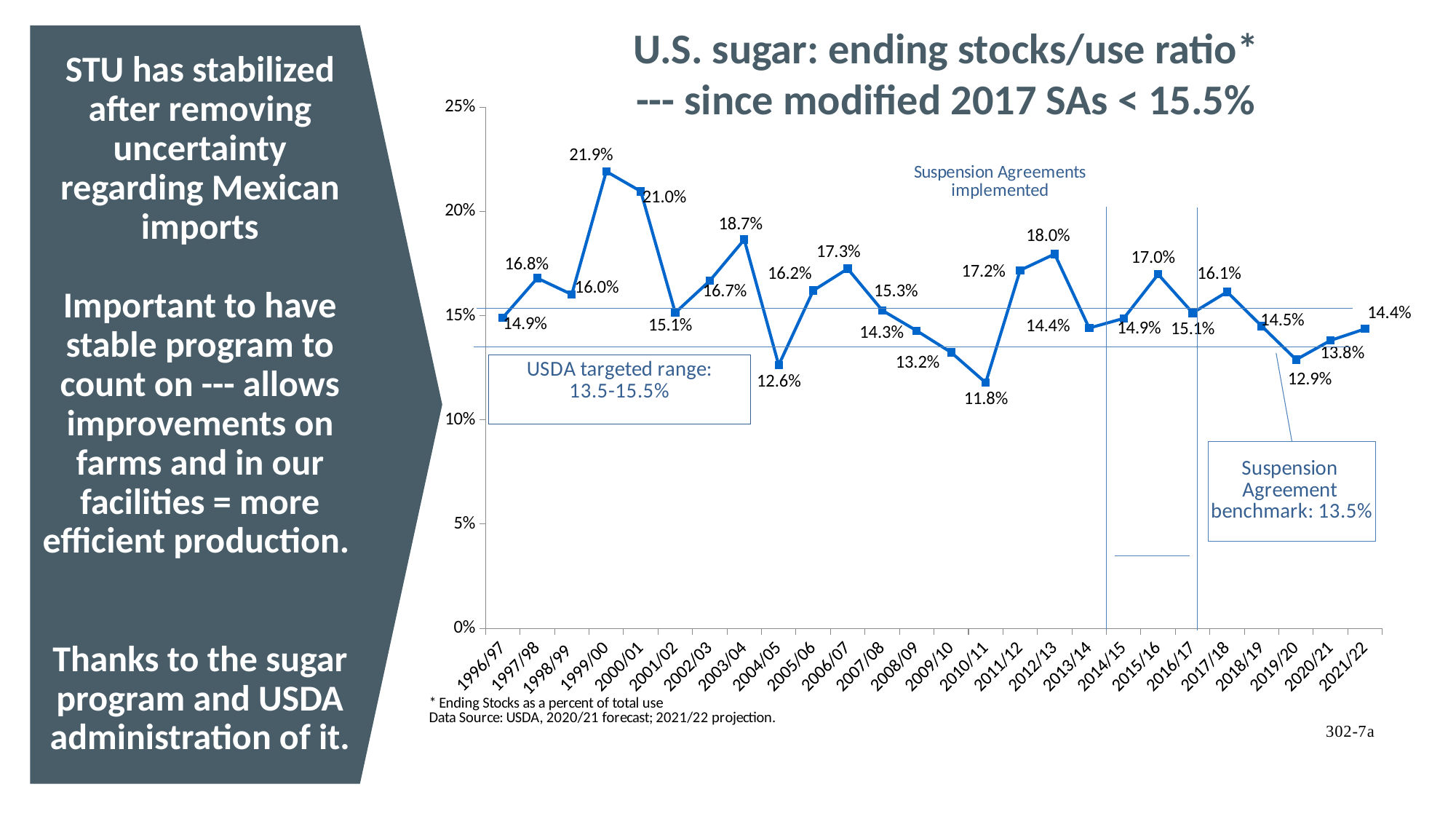
What USDA targeted range is shown in the box on the chart? 13.5-15.5% What is the ending stocks/use ratio for 1999/00? 21.9% What kind of chart is shown on the slide? Line chart How many years are plotted on the chart? 26 What is the ending stocks/use ratio for 2021/22? 14.4% What is the ending stocks/use ratio for 2010/11? 11.8% Does the ending stocks/use ratio rise or fall from 2017/18 to 2019/20? Fall What is the ending stocks/use ratio for 2004/05? 12.6% What is the difference between the ending stocks/use ratio in 1999/00 and in 2010/11? 10.1% Which year has the highest ending stocks/use ratio? 1999/00 Which year has a higher ending stocks/use ratio, 2012/13 or 2015/16? 2012/13 Which year has the lowest ending stocks/use ratio? 2010/11